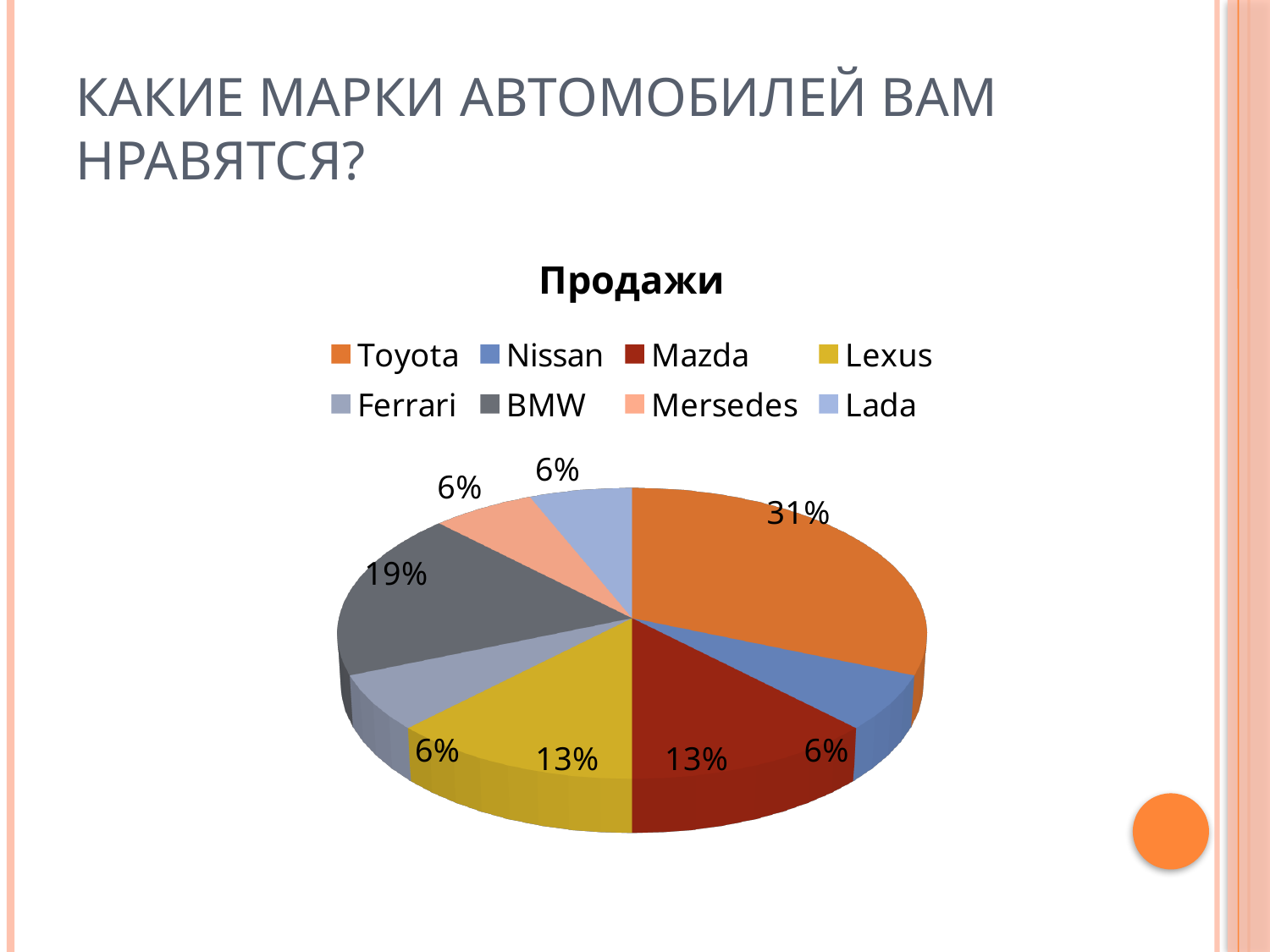
What kind of chart is shown on the slide? Pie chart What is the title of the chart? Продажи What share of the pie does Mazda have? 13% How many car brands does the legend list? 8 What is the difference between the Toyota share and the BMW share? 12% What share of the pie does BMW have? 19% What share of the pie does Nissan have? 6% Which is larger, the share for BMW or the share for Lexus? BMW Which colour represents Lexus in the chart? Yellow Which brand has the largest slice of the pie? Toyota What is the difference between the Lexus share and the Ferrari share? 7%